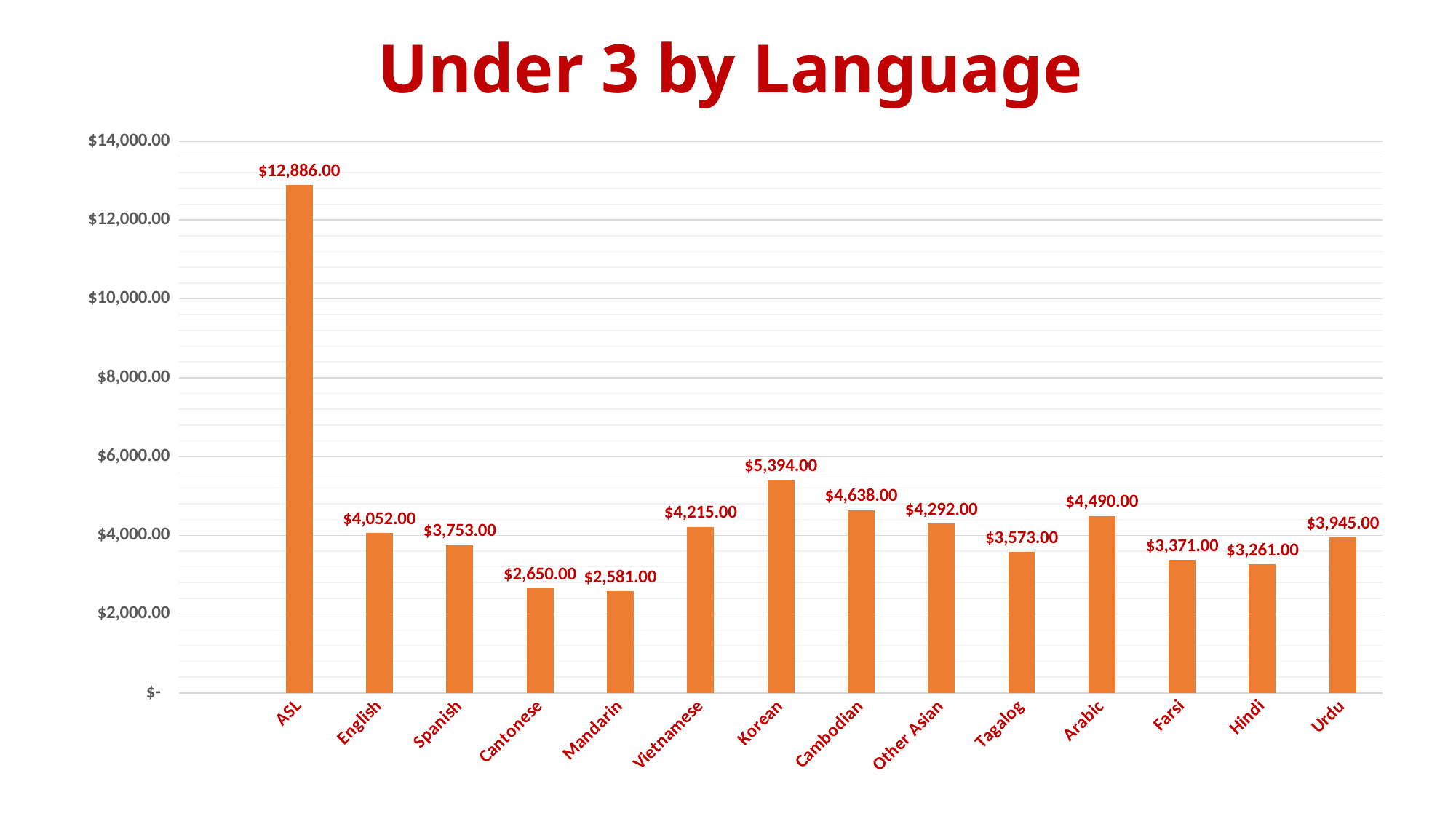
What is the difference between the values for Korean and Cambodian? $756.00 What is the value for Korean? $5,394.00 What is the value for Urdu? $3,945.00 Is the value for Farsi greater or less than $4,000.00? less What is the value for Mandarin? $2,581.00 What kind of chart is shown on the slide? Bar chart Which is larger, the value for Arabic or the value for Other Asian? Arabic What is the difference between the values for English and Spanish? $299.00 Which language has the lowest value? Mandarin What is the value for ASL? $12,886.00 Which language has the highest value? ASL How many languages are shown on the chart? 14